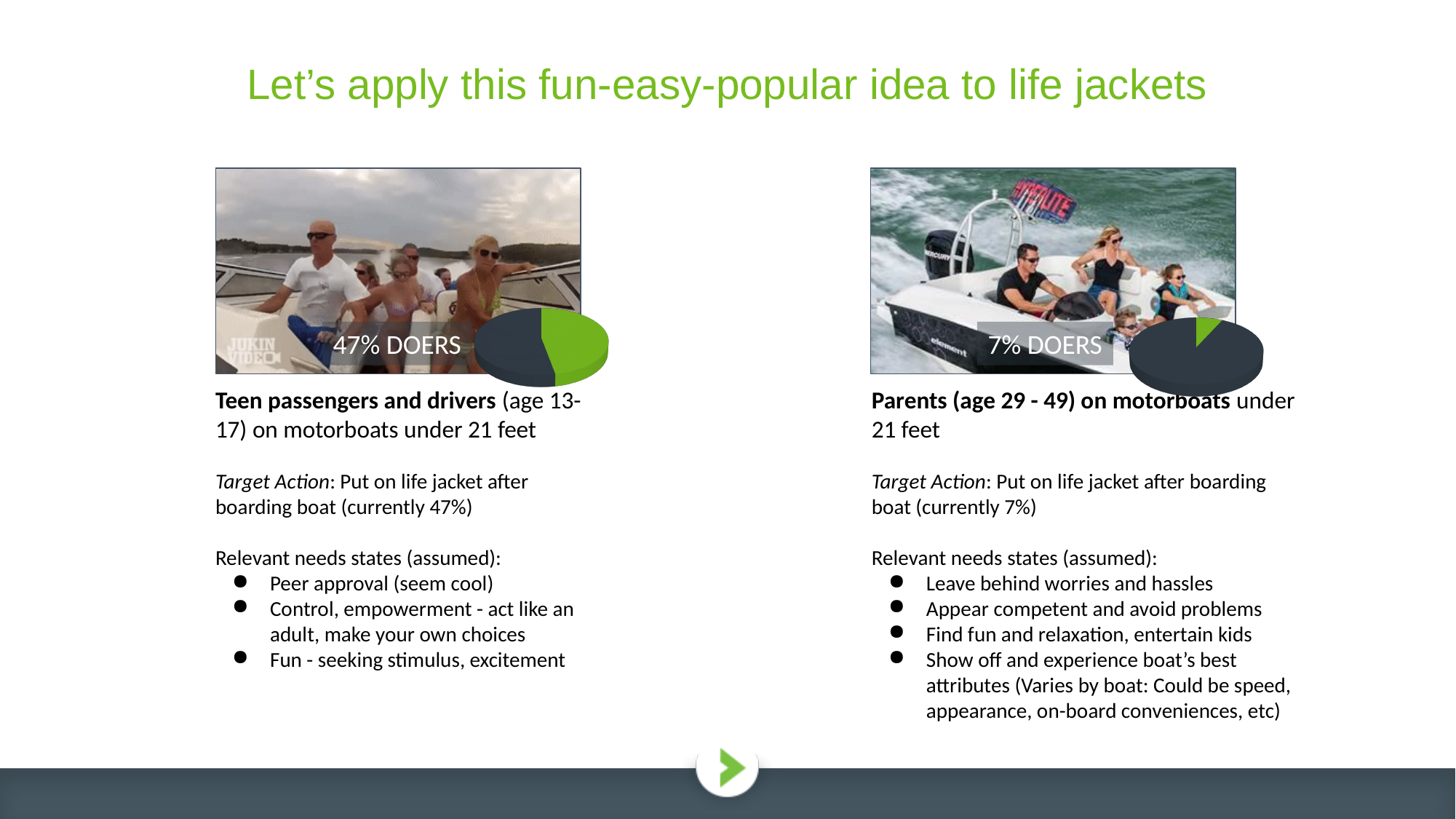
What is the difference in percentage points between the DOERS share in the left pie chart and the DOERS share in the right pie chart? 40 percentage points How many slices does the right pie chart (parents) have? 2 What colour is the DOERS slice in both pie charts? green In the right pie chart (parents), is the DOERS share greater or less than 10%? less In the left pie chart (teens), is the DOERS share greater or less than 50%? less What kind of chart is shown next to the teen passengers photo on the left? pie chart In the right pie chart (parents on motorboats), what share of the pie is labelled as DOERS? 7% Which pie chart shows the larger DOERS share, the left one (teens) or the right one (parents)? the left one (teens) What text label is printed beside the right pie chart (parents)? 7% DOERS What kind of chart is shown next to the parents photo on the right? pie chart How many slices does the left pie chart (teens) have? 2 In the left pie chart (teen passengers and drivers), what share of the pie is labelled as DOERS? 47%